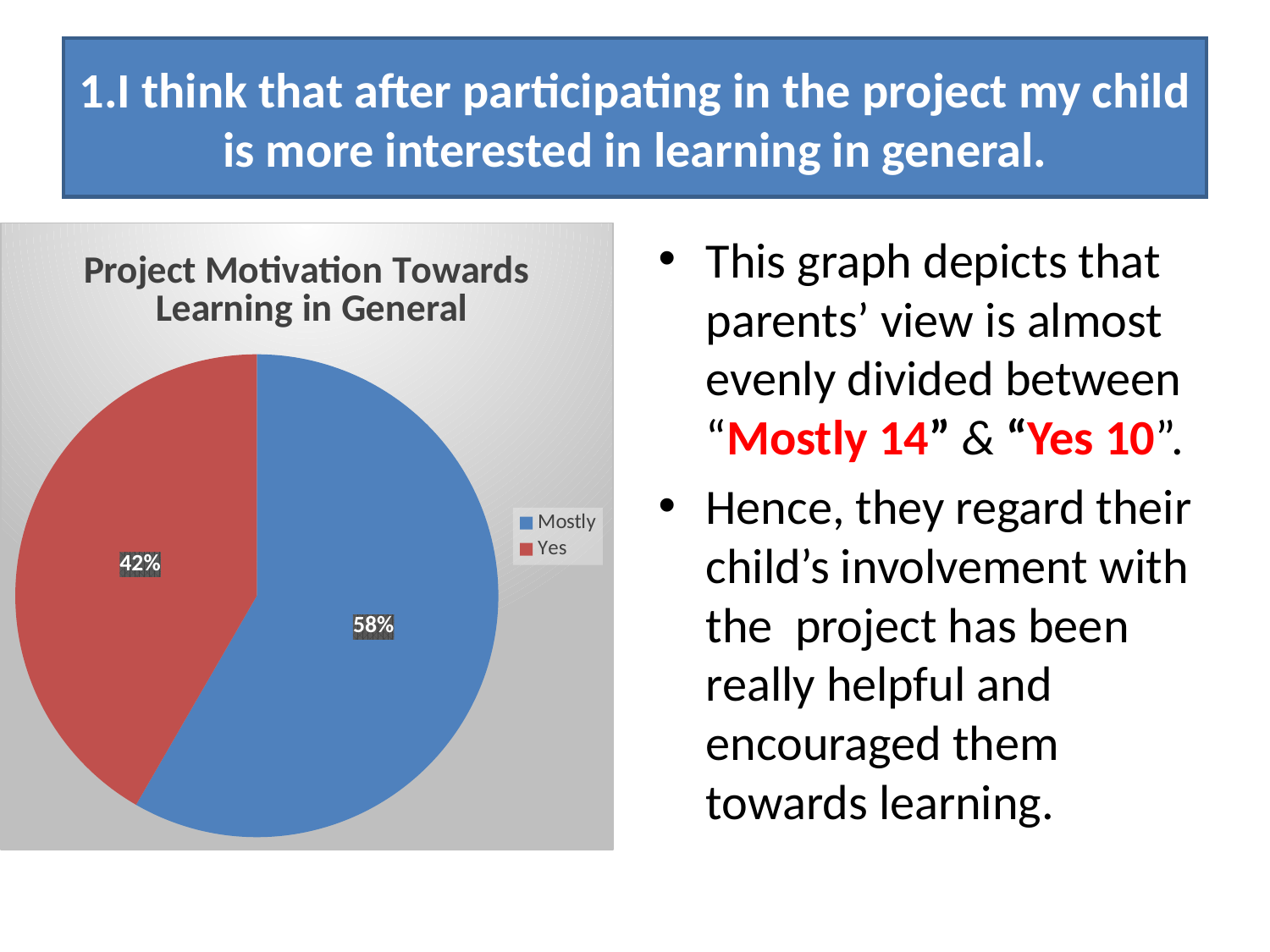
What type of chart is shown on the slide? pie chart How many slices does the pie chart have? 2 Which category has the smallest share of the pie? Yes What percentage of the pie does the "Mostly" slice represent? 58% How many entries does the legend list? 2 What percentage of the pie does the "Yes" slice represent? 42% What is the difference in percentage points between the "Mostly" and "Yes" slices? 16% What colour is the "Yes" slice in the pie chart? red Which slice is larger, "Mostly" or "Yes"? Mostly What is the title of the chart? Project Motivation Towards Learning in General Is the share for "Yes" greater or less than 50%? less Which category has the largest share of the pie? Mostly